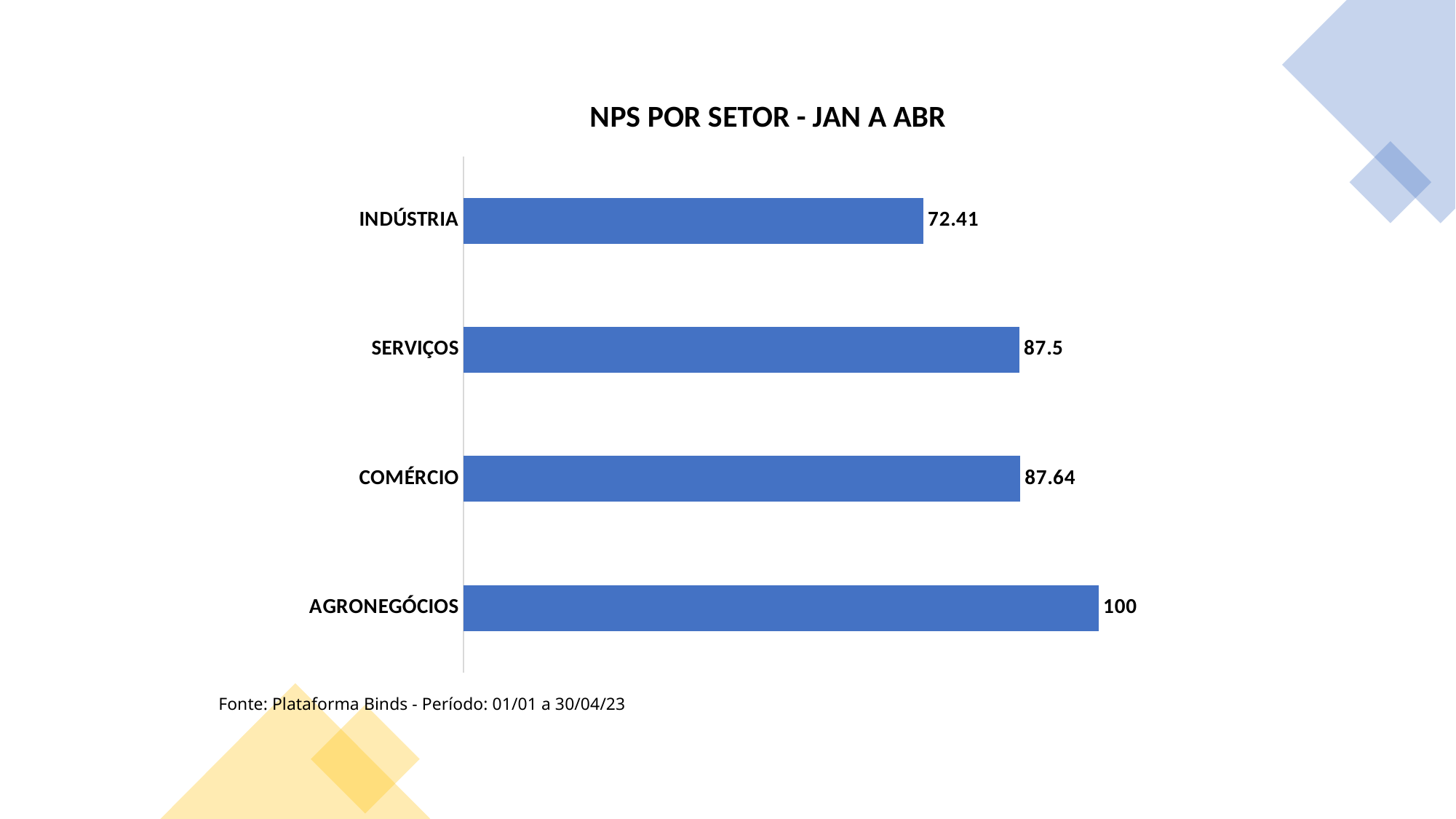
Which sector has the lowest NPS? INDÚSTRIA Which sector has the highest NPS? AGRONEGÓCIOS What is the title of the chart? NPS POR SETOR - JAN A ABR How many sectors are shown in the chart? 4 What kind of chart is shown on the slide? Bar chart What is the difference between the NPS of AGRONEGÓCIOS and INDÚSTRIA? 27.59 Which has a higher NPS, AGRONEGÓCIOS or INDÚSTRIA? AGRONEGÓCIOS What is the NPS value for AGRONEGÓCIOS? 100 What is the NPS value for INDÚSTRIA? 72.41 What is the NPS value for COMÉRCIO? 87.64 What is the NPS value for SERVIÇOS? 87.5 What is the difference between the NPS of COMÉRCIO and SERVIÇOS? 0.14